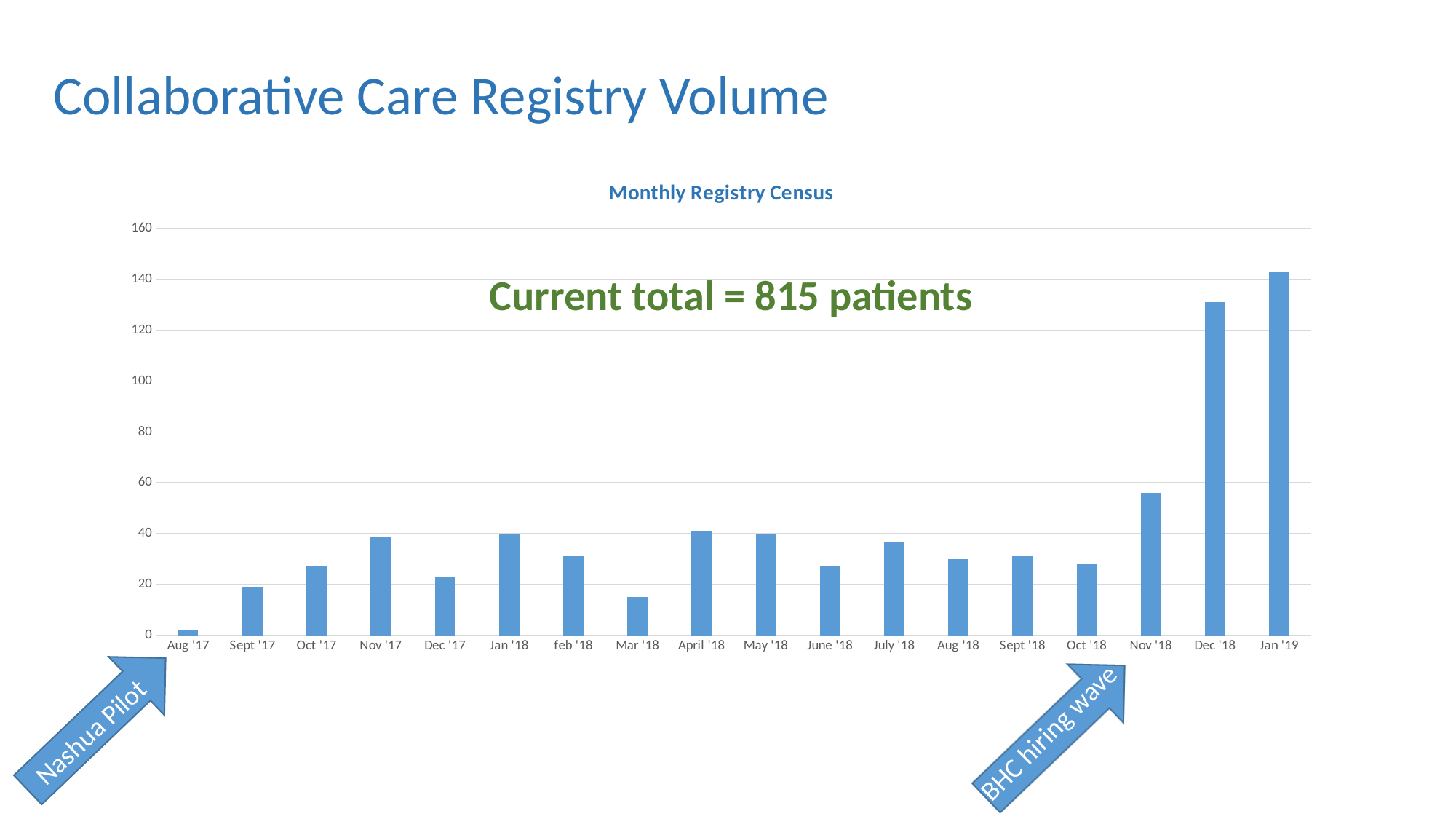
How many months are plotted on the x axis? 18 What is the title of the chart? Monthly Registry Census Is the value for Dec '18 greater or less than 120? greater Is the value for Jan '19 greater or less than 140? greater What current total of patients is stated on the chart? 815 patients Which month has the highest registry census? Jan '19 Do the values generally rise or fall from Oct '18 to Jan '19? rise Which month has the lowest registry census? Aug '17 Which month has a larger value, Dec '18 or Nov '18? Dec '18 Is the value for Mar '18 greater or less than 20? less What kind of chart is shown on the slide? bar chart